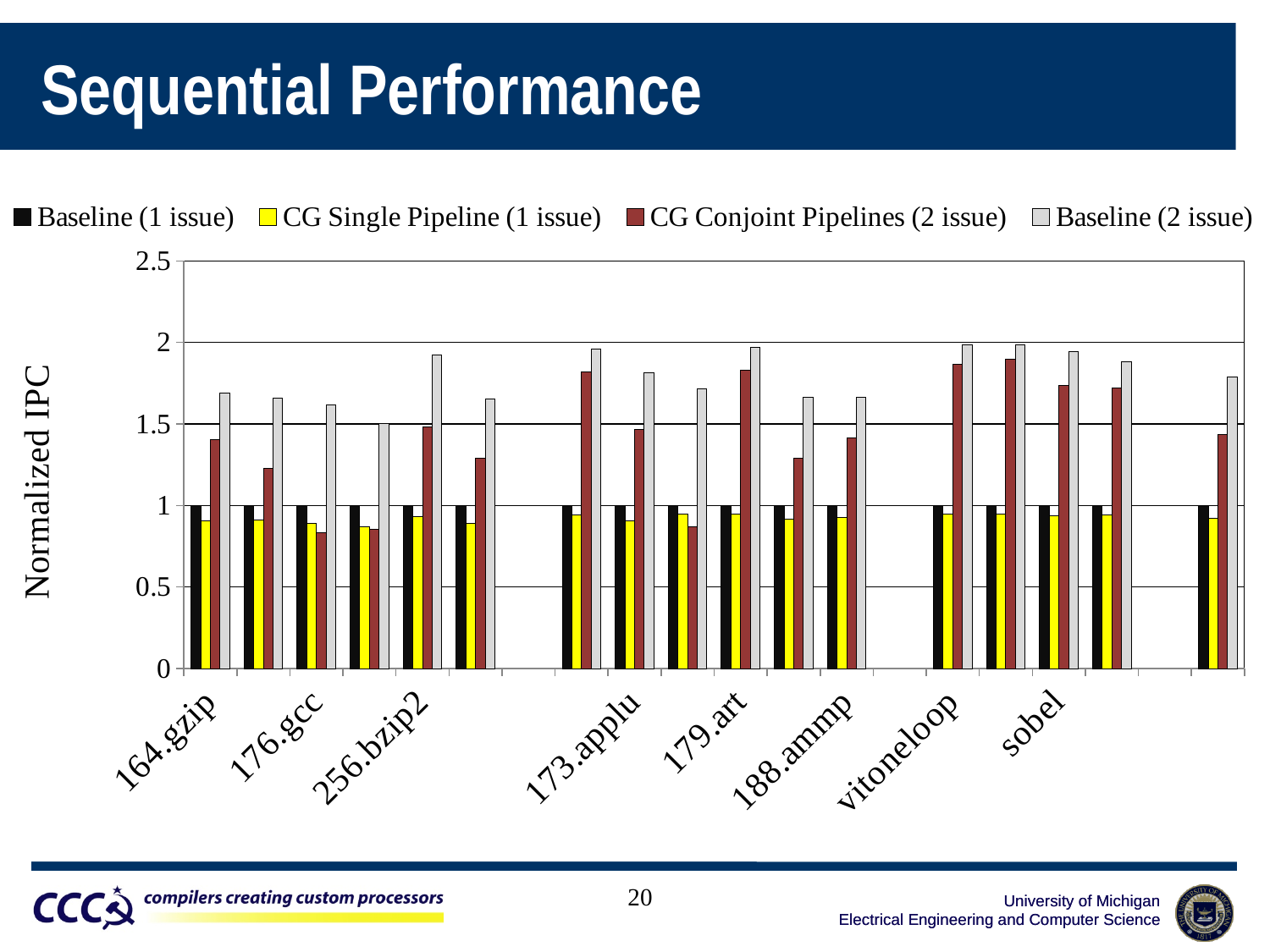
What is the Normalized IPC value for Baseline (1 issue) for 164.gzip? 1 Is the value for Baseline (2 issue) for 164.gzip greater or less than 1.5? greater Which series has the lowest value for 164.gzip? CG Single Pipeline (1 issue) Is the value for CG Single Pipeline (1 issue) for 164.gzip greater or less than 1? less Is the value for CG Conjoint Pipelines (2 issue) for 164.gzip greater or less than 1.5? less What kind of chart is shown on the slide? bar chart For 176.gcc, which is larger: CG Conjoint Pipelines (2 issue) or Baseline (2 issue)? Baseline (2 issue) How many series does the legend list? 4 Which series has the highest value for 173.applu? Baseline (2 issue) What is the y-axis title of the chart? Normalized IPC What is the title of the slide containing the chart? Sequential Performance